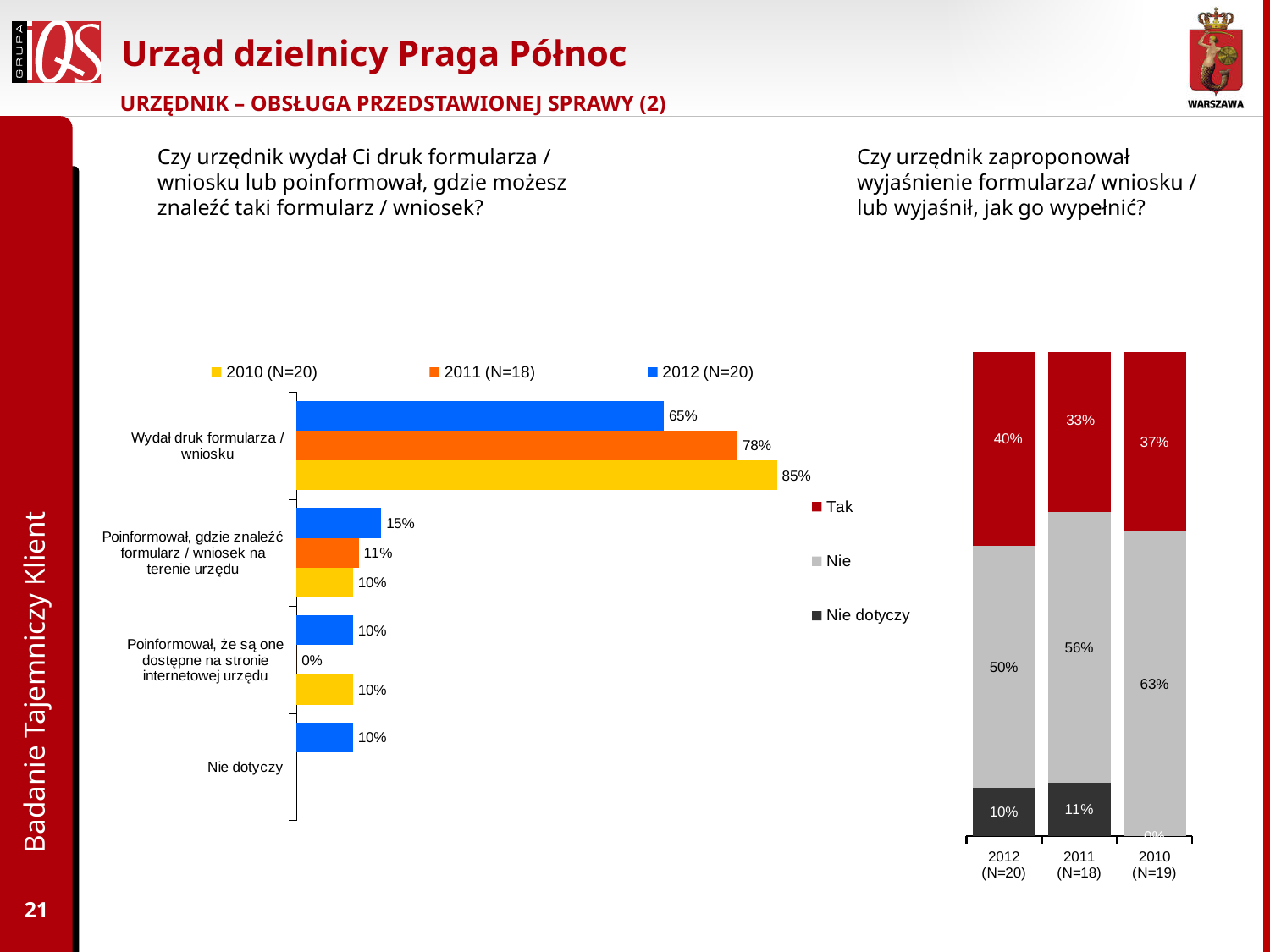
In the right chart, how many categories (years) are shown on the x axis? 3 In the right chart, what is the 'Tak' share for 2012 (N=20)? 40% What type of chart is the left chart? Bar chart In the right chart, is the 'Nie' share for 2011 larger or smaller than the 'Nie' share for 2012? Larger In the left chart, what is the 2010 (N=20) value for 'Wydał druk formularza / wniosku'? 85% In the left chart, what is the 2011 (N=18) value for 'Poinformował, że są one dostępne na stronie internetowej urzędu'? 0% In the left chart, how many series does the legend list? 3 In the left chart, what is the 2012 (N=20) value for 'Poinformował, gdzie znaleźć formularz / wniosek na terenie urzędu'? 15% In the right chart, which year has the lowest 'Tak' share? 2011 (N=18) In the left chart, what is the difference between the 2010 and 2012 values for 'Wydał druk formularza / wniosku'? 20 percentage points In the right chart, what is the 'Nie' share for 2010 (N=19)? 63% In the left chart, which year has the highest value for 'Wydał druk formularza / wniosku'? 2010 (N=20)